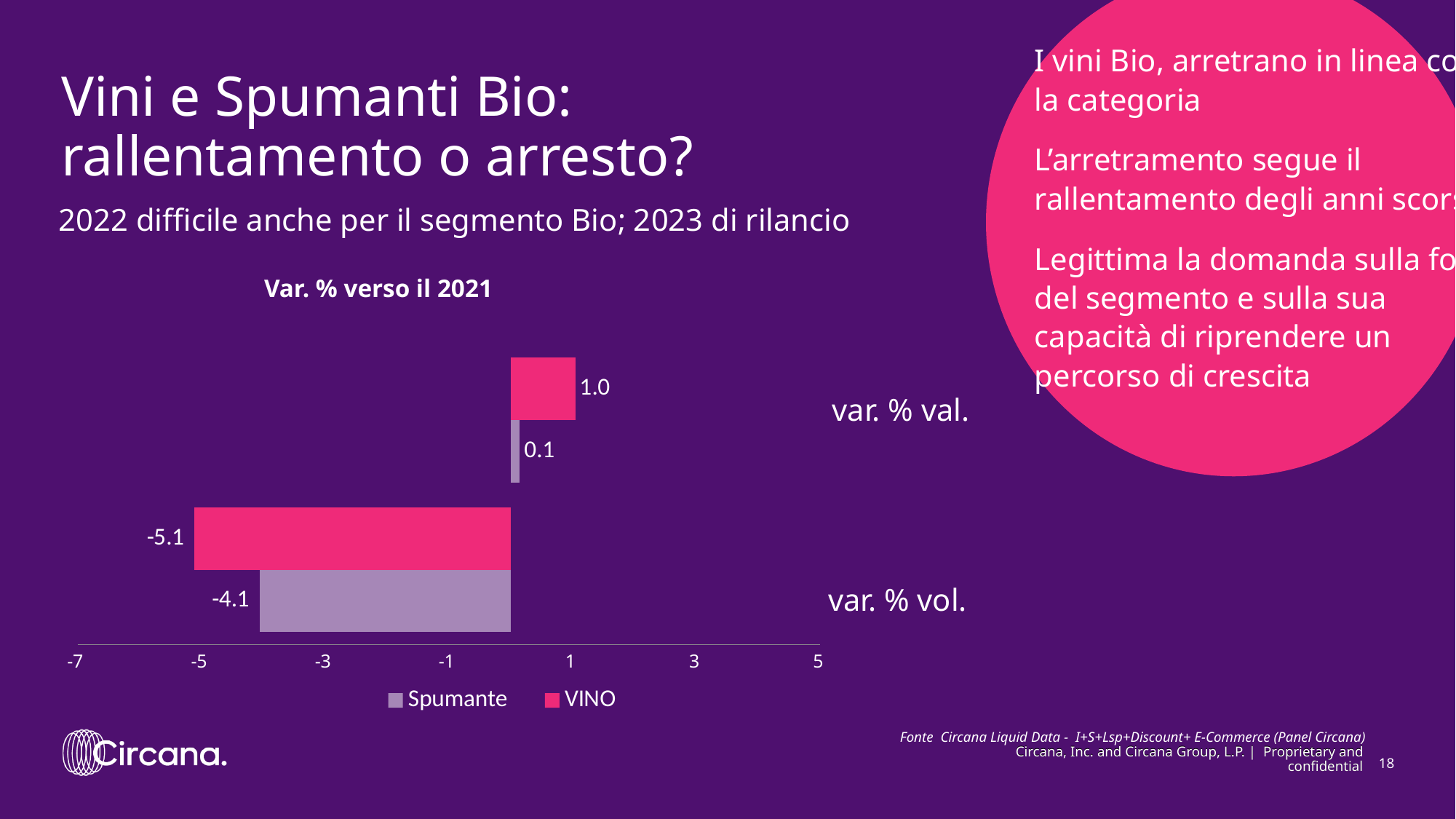
Which series has the lowest value in the var. % vol. category? VINO What is the title of the chart? Var. % verso il 2021 What is the value for VINO in the var. % vol. category? -5.1 What is the value for VINO in the var. % val. category? 1.0 What is the value for Spumante in the var. % vol. category? -4.1 What is the difference between the VINO and Spumante values in the var. % val. category? 0.9 What is the value for Spumante in the var. % val. category? 0.1 Which series has the highest value in the var. % val. category? VINO Is the VINO value for var. % vol. greater or less than -5? less What is the difference between the Spumante and VINO values in the var. % vol. category? 1.0 What kind of chart is shown on the slide? Bar chart How many series does the legend list? 2